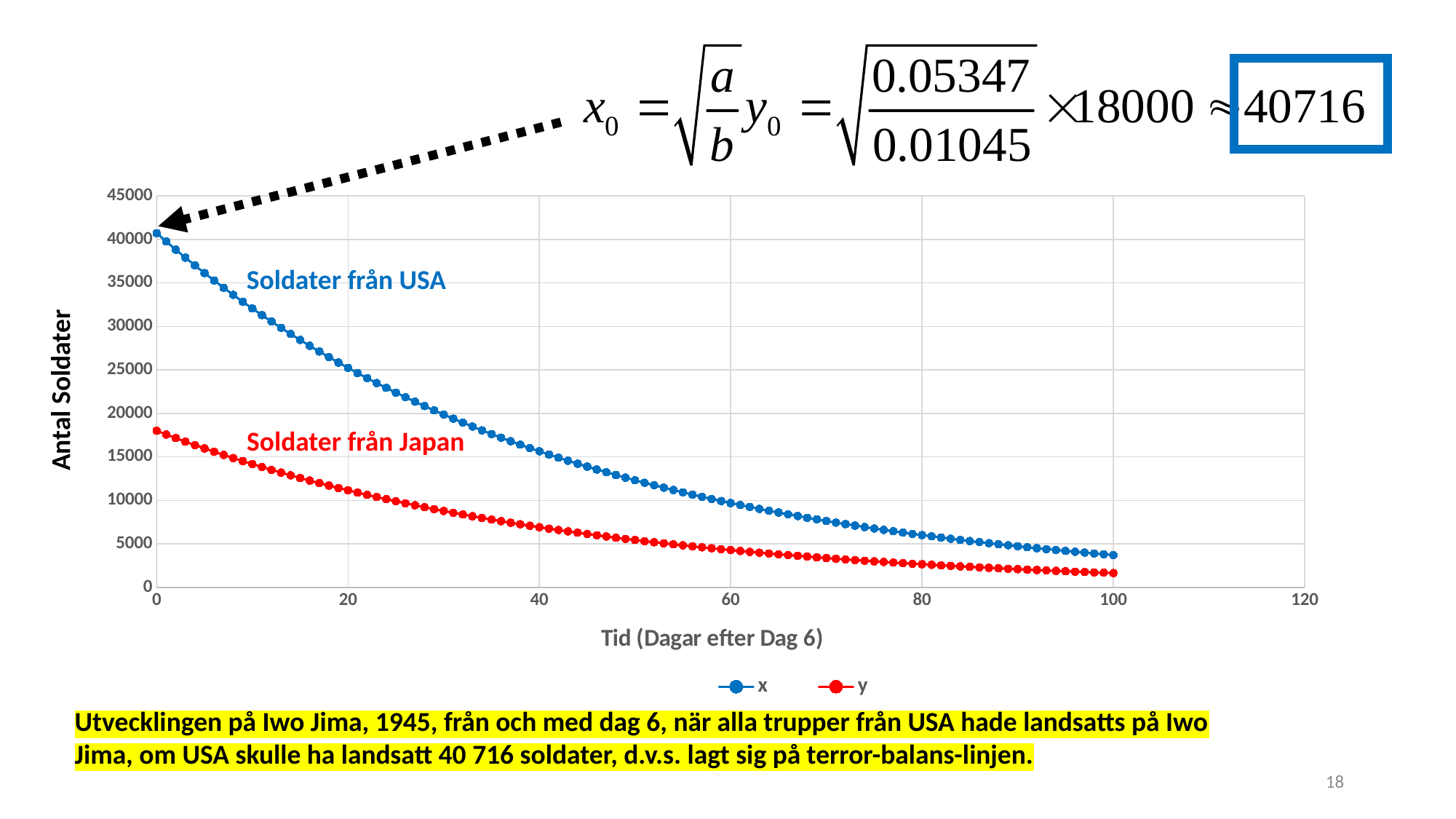
What are the two series names shown in the legend? x and y What kind of chart is shown on the slide? line chart Is the value of series x at day 0 greater or less than 35000? greater At day 0, which series has the larger value, x or y? x Do the values of series x rise or fall as time increases along the x axis? fall Do the values of series y rise or fall as time increases along the x axis? fall Is the value of series x at day 100 greater or less than 5000? less What is the title of the vertical axis? Antal Soldater Is the value of series y at day 0 greater or less than 20000? less What is the starting value of series y (Soldater från Japan) at day 0, as given in the formula on the slide? 18000 How many series does the chart's legend list? 2